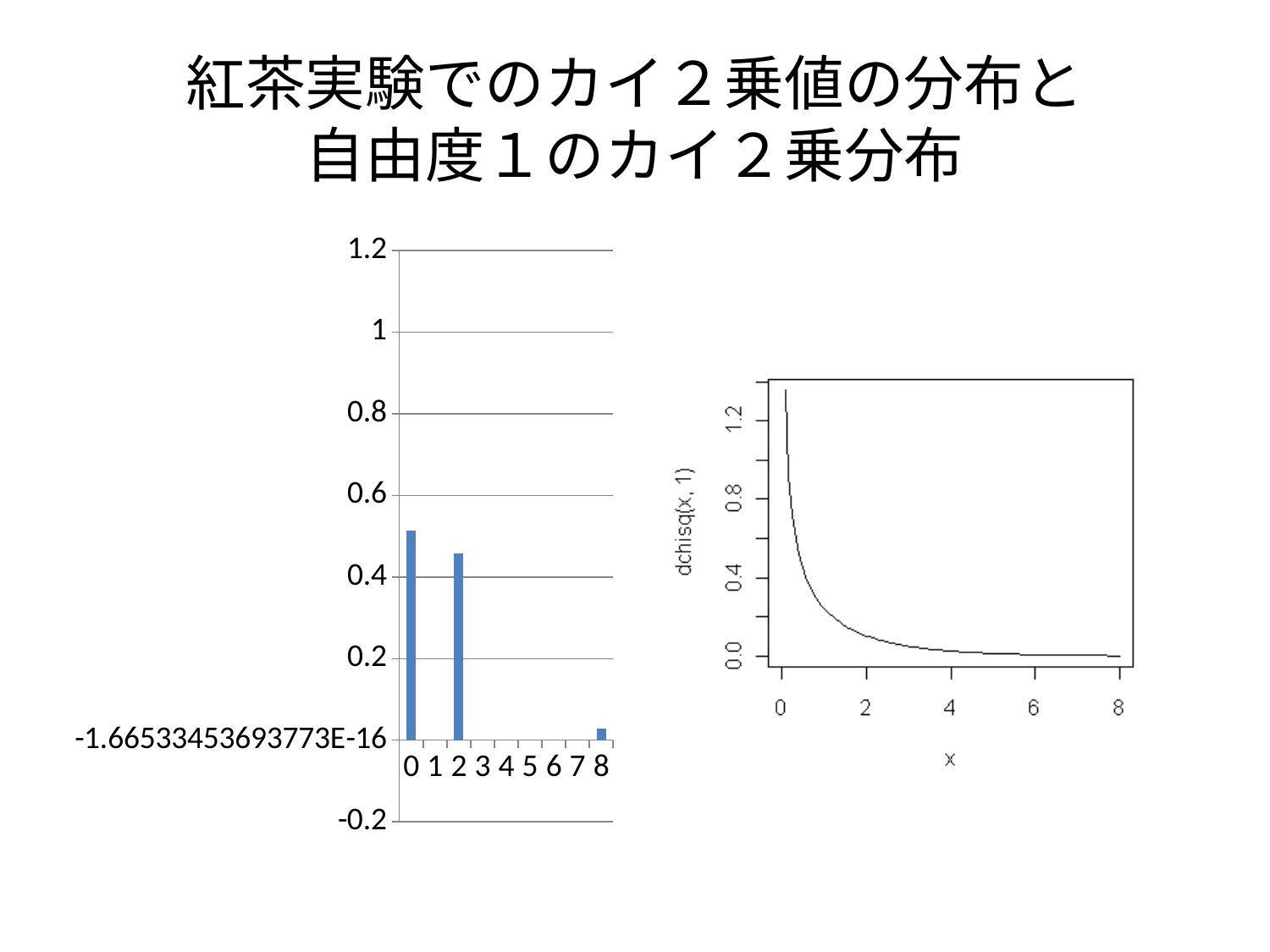
In the line chart on the right, what is the label on the y axis? dchisq(x, 1) In the bar chart on the left, which category has the tallest bar? 0 What kind of chart is the chart on the right of the slide? line chart In the bar chart on the left, how many categories are labelled on the x axis? 9 What kind of chart is the chart on the left of the slide? bar chart In the bar chart on the left, is the value for category 0 greater or less than 0.4? greater In the bar chart on the left, which is larger, the value for category 2 or the value for category 8? category 2 In the bar chart on the left, is the value for category 2 greater or less than 0.6? less In the bar chart on the left, is the value for category 8 greater or less than 0.2? less In the line chart on the right, does the curve rise or fall as x increases? fall In the bar chart on the left, how many categories have a visible bar? 3 In the bar chart on the left, what is the highest value shown on the y axis? 1.2